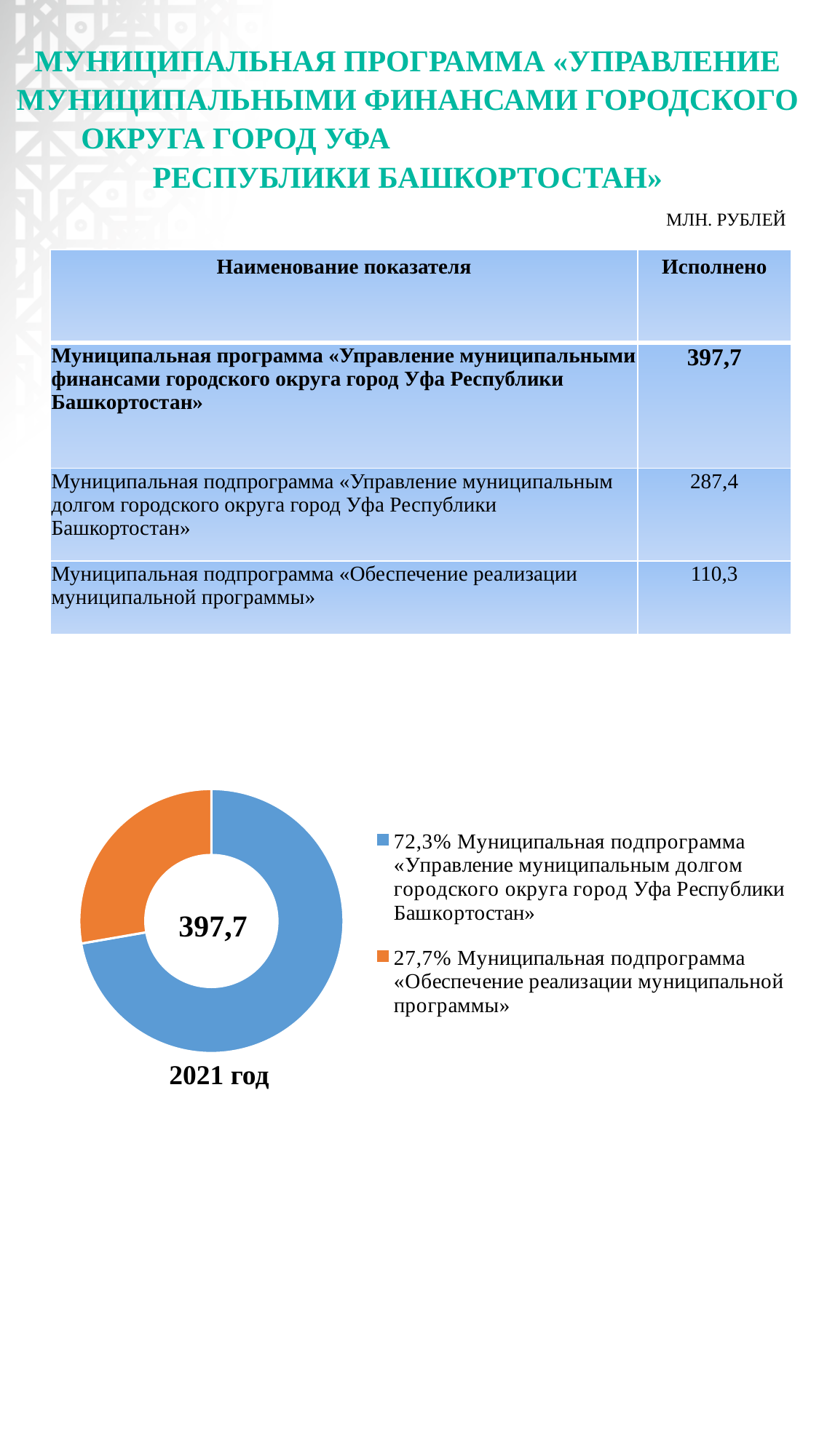
By how many percentage points does the share of the debt management subprogram exceed the share of the program implementation subprogram in the doughnut chart? 44,6 percentage points What year is given as the label under the doughnut chart? 2021 год Which slice of the doughnut chart is the smallest? Муниципальная подпрограмма «Обеспечение реализации муниципальной программы» Which slice of the doughnut chart is the largest? Муниципальная подпрограмма «Управление муниципальным долгом городского округа город Уфа Республики Башкортостан» How many slices does the doughnut chart have? 2 What share of the doughnut chart does the subprogram «Обеспечение реализации муниципальной программы» take? 27,7% What share of the doughnut chart does the subprogram «Управление муниципальным долгом городского округа город Уфа Республики Башкортостан» take? 72,3% What colour is the slice for the subprogram «Обеспечение реализации муниципальной программы» in the doughnut chart? Orange What total value is printed in the centre of the doughnut chart? 397,7 Which is larger in the doughnut chart: the share of the debt management subprogram or the share of the program implementation subprogram? The debt management subprogram (72,3%) How many entries does the legend of the doughnut chart list? 2 What kind of chart is shown on the slide? Doughnut (pie) chart